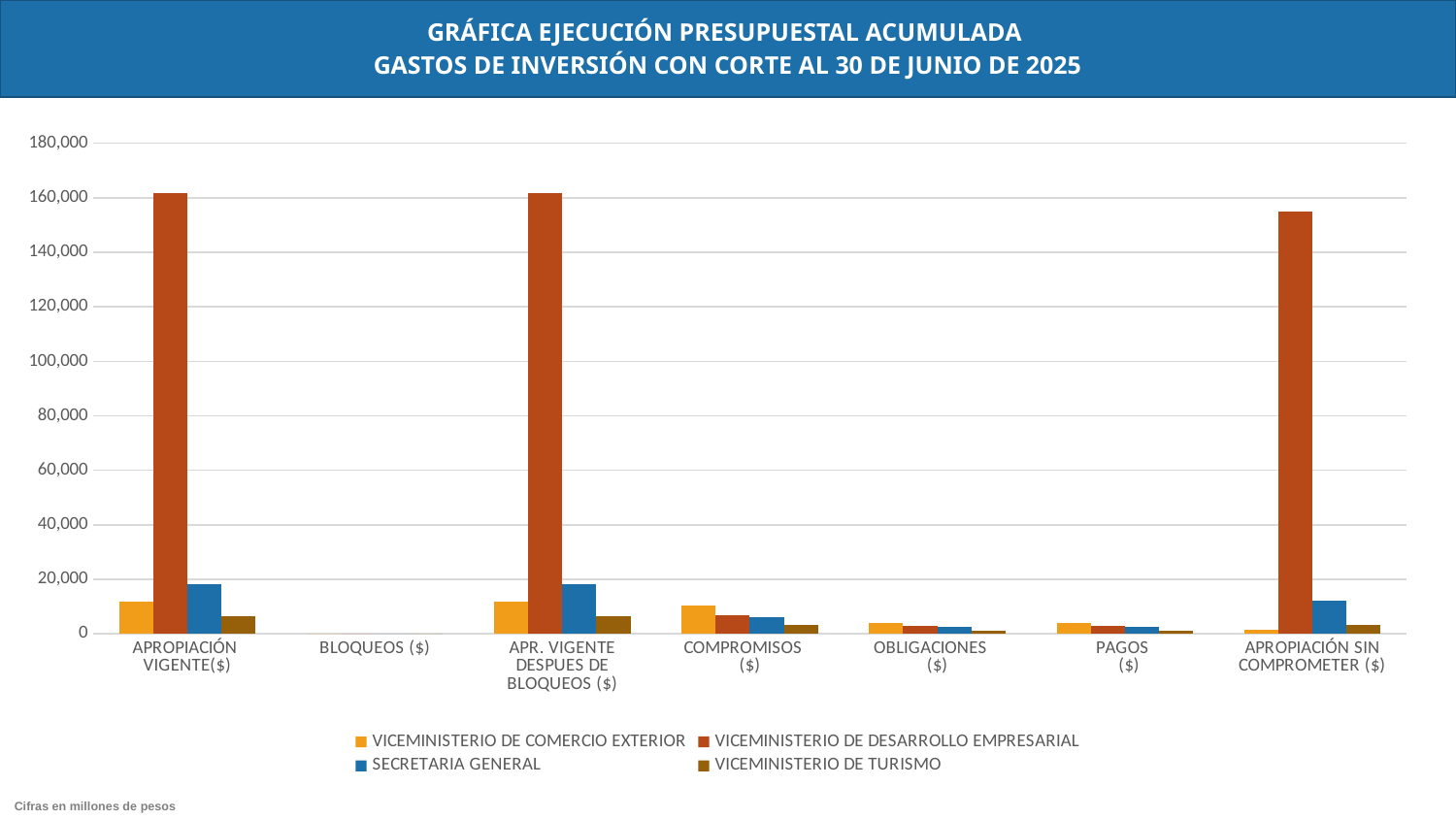
How many series does the legend list? 4 Which series has the highest value in the APROPIACIÓN VIGENTE($) category? VICEMINISTERIO DE DESARROLLO EMPRESARIAL Is the value for VICEMINISTERIO DE DESARROLLO EMPRESARIAL in APROPIACIÓN SIN COMPROMETER ($) greater or less than 140,000? greater Which series has the lowest value in the APROPIACIÓN VIGENTE($) category? VICEMINISTERIO DE TURISMO What kind of chart is shown on the slide? bar chart Which category shows no visible bars for any series? BLOQUEOS ($) In the APROPIACIÓN SIN COMPROMETER ($) category, which is larger: SECRETARIA GENERAL or VICEMINISTERIO DE COMERCIO EXTERIOR? SECRETARIA GENERAL In the COMPROMISOS ($) category, which is larger: VICEMINISTERIO DE COMERCIO EXTERIOR or VICEMINISTERIO DE DESARROLLO EMPRESARIAL? VICEMINISTERIO DE COMERCIO EXTERIOR Is the value for VICEMINISTERIO DE DESARROLLO EMPRESARIAL in APROPIACIÓN VIGENTE($) greater or less than 140,000? greater Is the value for SECRETARIA GENERAL in APROPIACIÓN VIGENTE($) greater or less than 20,000? less How many categories are shown along the x axis? 7 What colour represents SECRETARIA GENERAL in the legend? blue